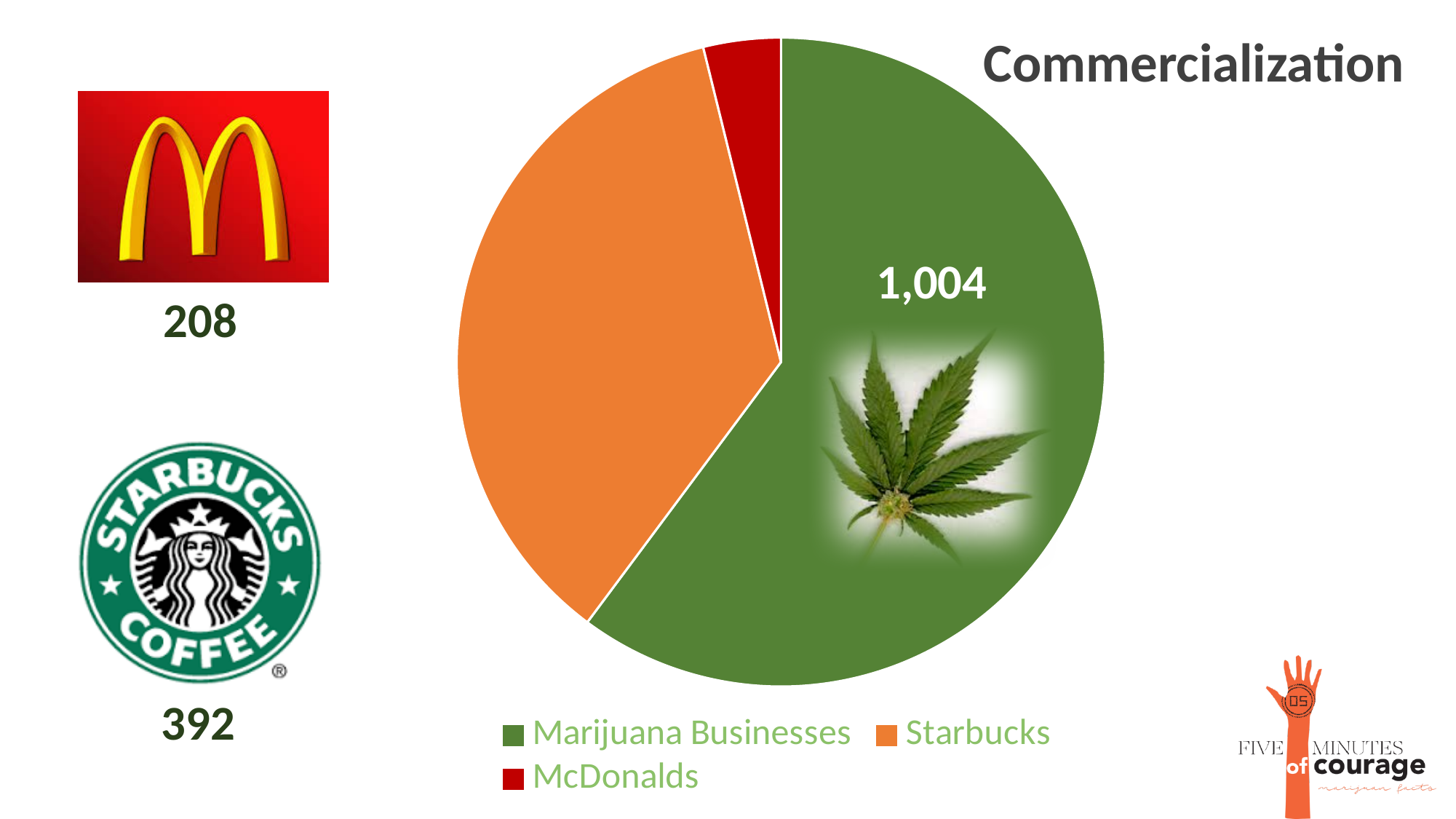
What is the difference between the Marijuana Businesses value and the Starbucks value? 612 How many slices does the pie chart have? 3 What kind of chart is shown on the slide? pie chart How many entries does the legend list? 3 What value is shown for McDonalds on the slide? 208 Which category has the smallest slice of the pie? McDonalds Which slice is larger, Starbucks or McDonalds? Starbucks What colour is the McDonalds slice in the pie chart? red What value is labelled on the Marijuana Businesses slice? 1,004 What value is shown for Starbucks on the slide? 392 What is the title of the chart? Commercialization Which category has the largest slice of the pie? Marijuana Businesses